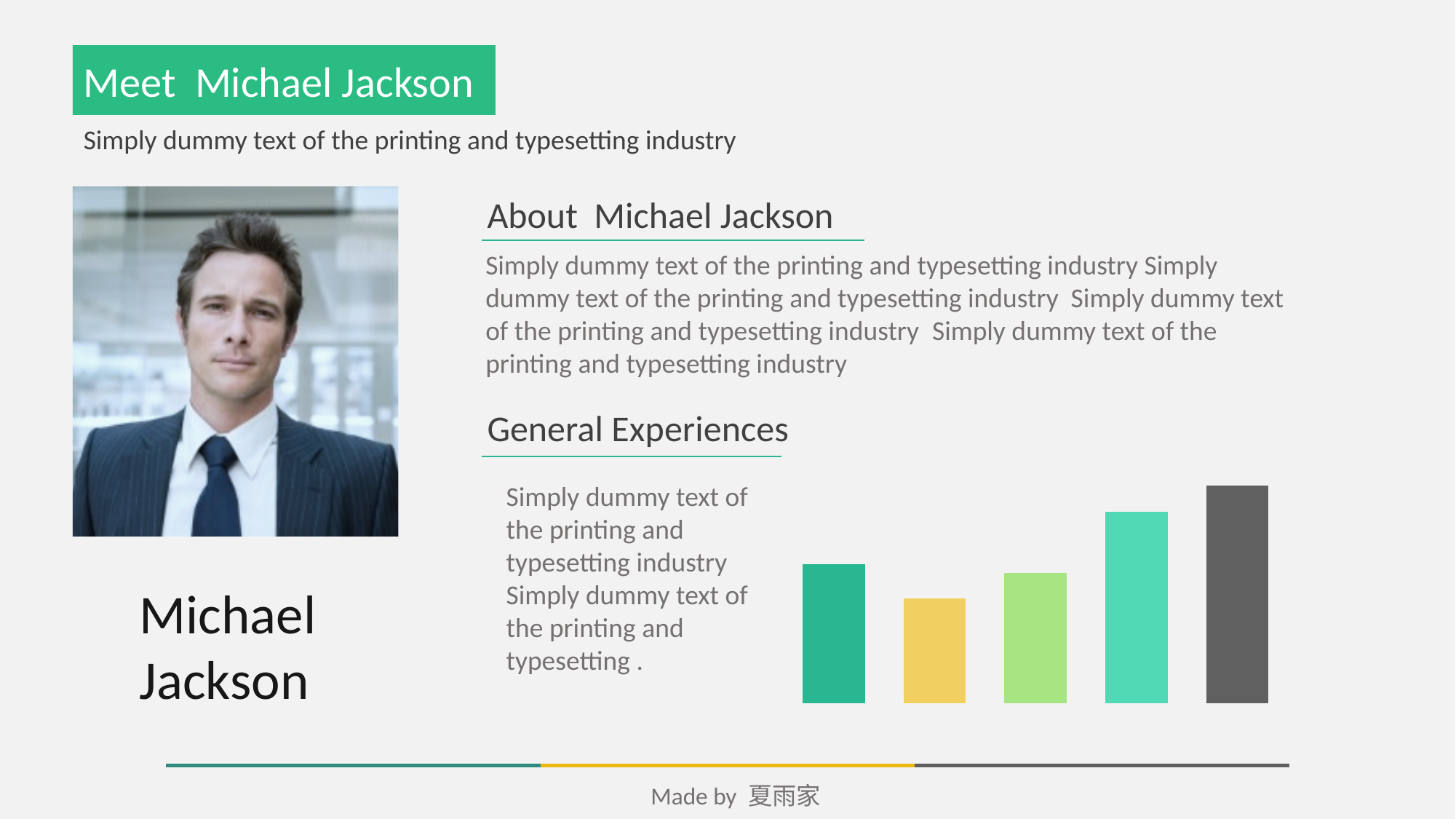
What colour is the tallest bar in the chart? dark grey What kind of chart is shown on the slide? bar chart Do the bars rise or fall from the second bar to the fifth bar? rise Which bar in the chart is the shortest? the second bar from the left (yellow) Does the chart display any axis labels or data values? No Is the rightmost bar taller or shorter than the leftmost bar? taller Is the yellow bar taller or shorter than the light green bar next to it? shorter How many bars does the chart on the slide have? 5 Which bar in the chart is the tallest? the rightmost (dark grey) bar